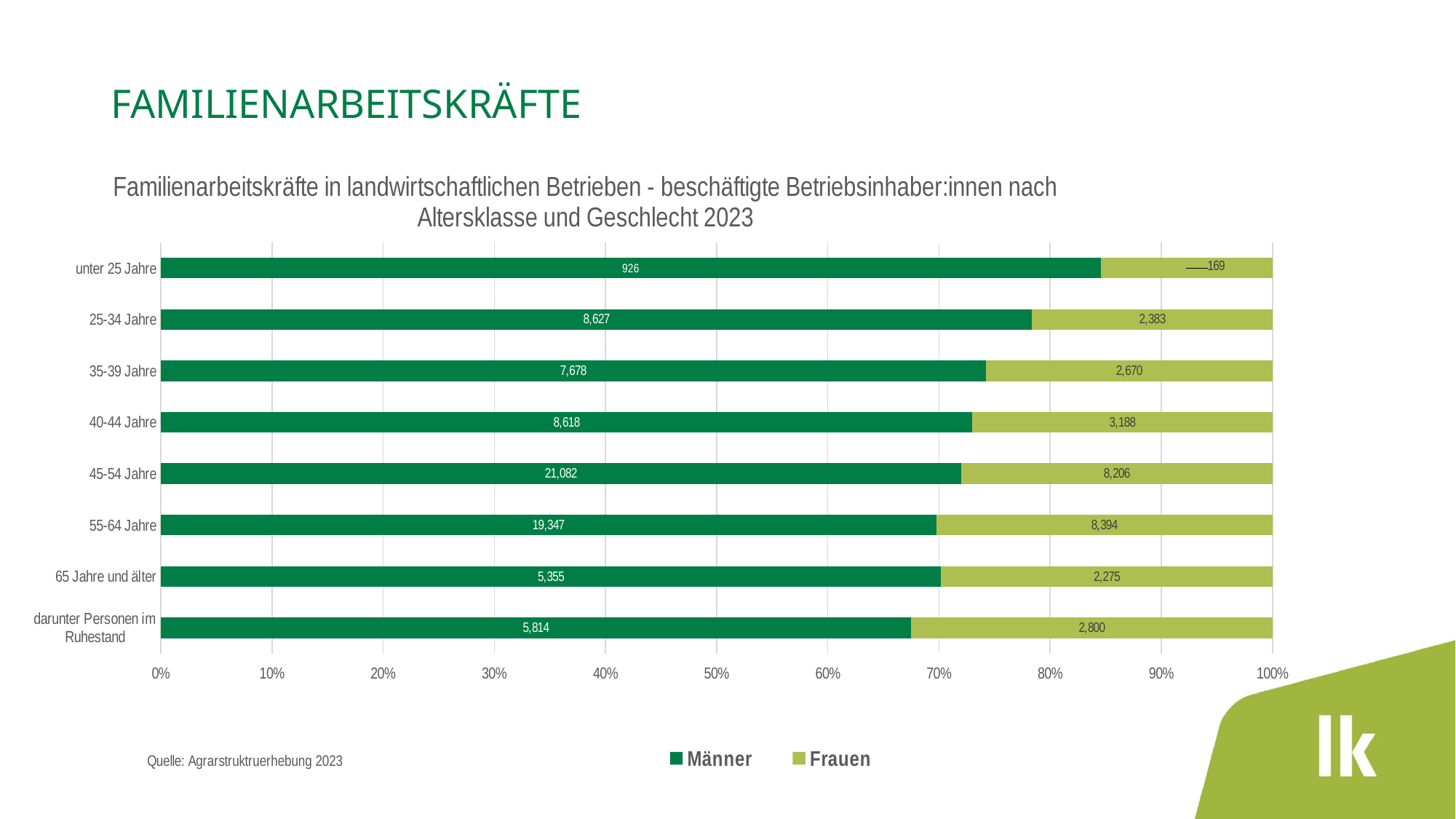
How many series does the legend list? 2 Which is larger: the Frauen value for 35-39 Jahre or the Frauen value for 25-34 Jahre? 35-39 Jahre Which age group has the lowest Männer value? unter 25 Jahre What is the Männer value for 'darunter Personen im Ruhestand'? 5,814 What is the difference between the Männer and Frauen values for the 45-54 Jahre age group? 12,876 What kind of chart is shown on the slide? Stacked bar chart What is the total of the Männer and Frauen values for the 25-34 Jahre age group? 11,010 Which age group has the highest Frauen value? 55-64 Jahre What is the Männer value for the 45-54 Jahre age group? 21,082 How many categories are shown on the vertical axis of the chart? 8 Is the Männer share of the bar for 40-44 Jahre greater or less than 70%? greater What is the Frauen value for the 25-34 Jahre age group? 2,383